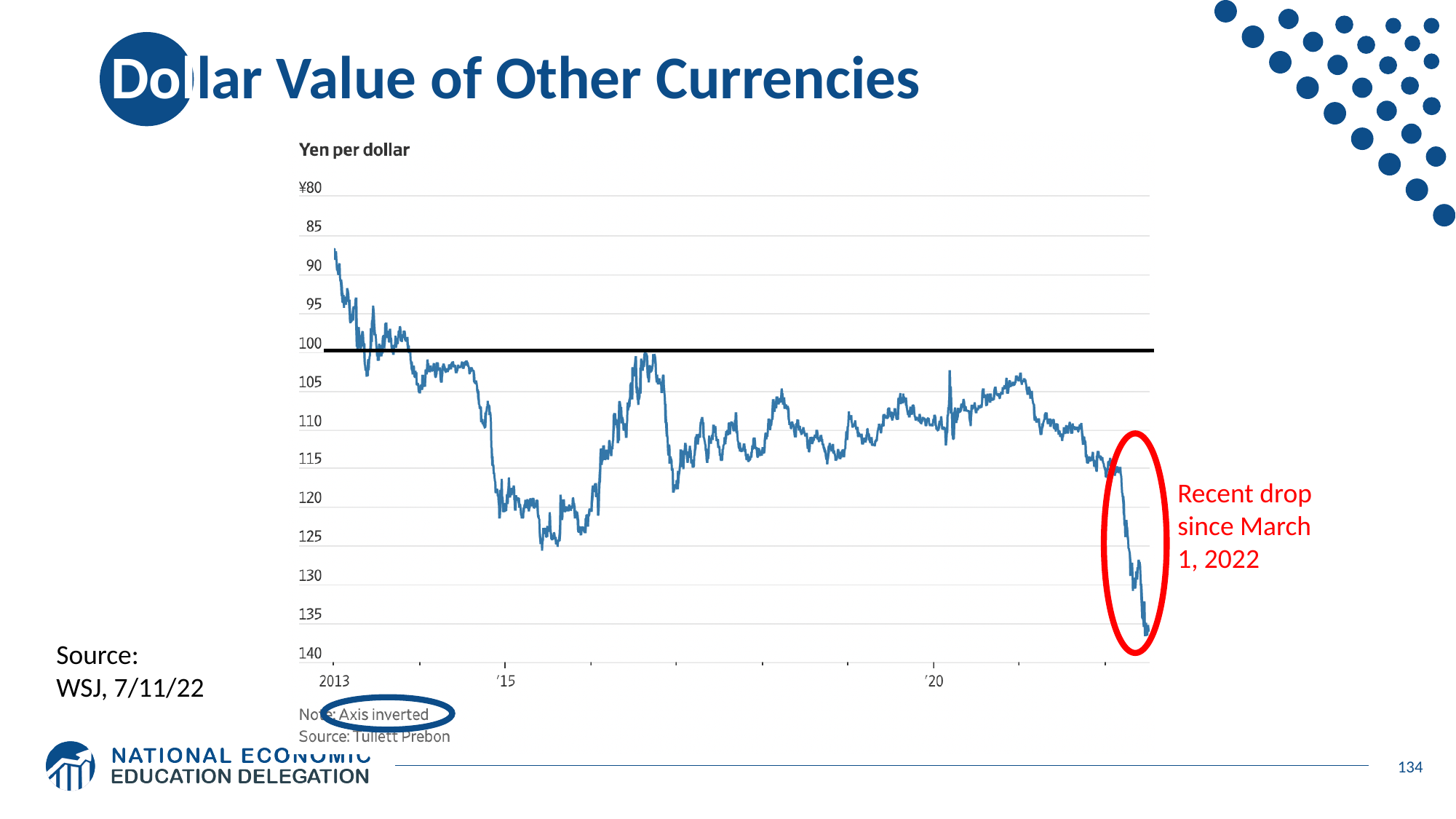
In which year does the line reach its numerically highest yen-per-dollar value? 2022 Overall, from 2013 to 2022, does the yen-per-dollar value rise or fall? rise Is the yen-per-dollar value at the very end of the series (mid-2022) greater or less than 130? greater Which is numerically larger: the yen-per-dollar value at the '15 tick or at the '20 tick? '15 What quantity does the y-axis of the chart measure, according to its label? Yen per dollar What kind of chart is shown on the slide? line chart Is the yen-per-dollar value at the start of the series in 2013 greater or less than 100? less What does the note beneath the chart say about the axis? Axis inverted Which is numerically larger: the yen-per-dollar value at the start of 2013 or at the end of the series in 2022? 2022 Is the yen-per-dollar value at the '20 tick mark greater or less than 100? greater How many data series are plotted on the chart? 1